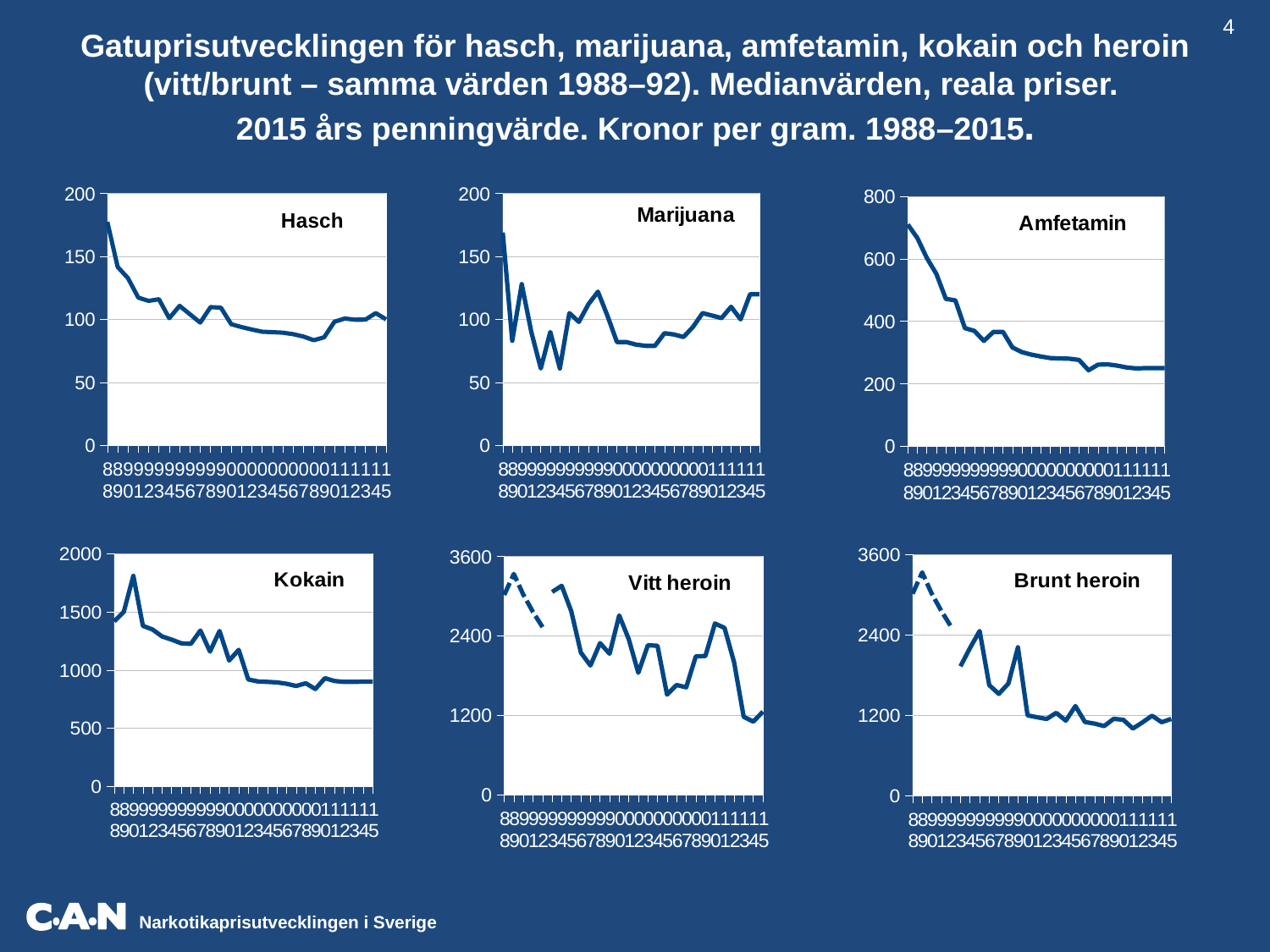
In the Amfetamin chart, is the value for 2015 greater or less than 200? greater In the Amfetamin chart, do the values generally rise or fall from 1988 to 2015? fall What kind of chart is the Hasch chart? line chart In the Amfetamin chart, which year has the highest value? 1988 In the Kokain chart, which is larger, the value for 1988 or the value for 2015? 1988 What is the title of the bottom-left chart? Kokain In the Amfetamin chart, is the value for 1988 greater or less than 600? greater In the Hasch chart, is the value for 1988 greater or less than 150? greater In the Kokain chart, which year has the highest value? 1990 In the Hasch chart, which year has the highest value? 1988 How many charts are shown on the slide? 6